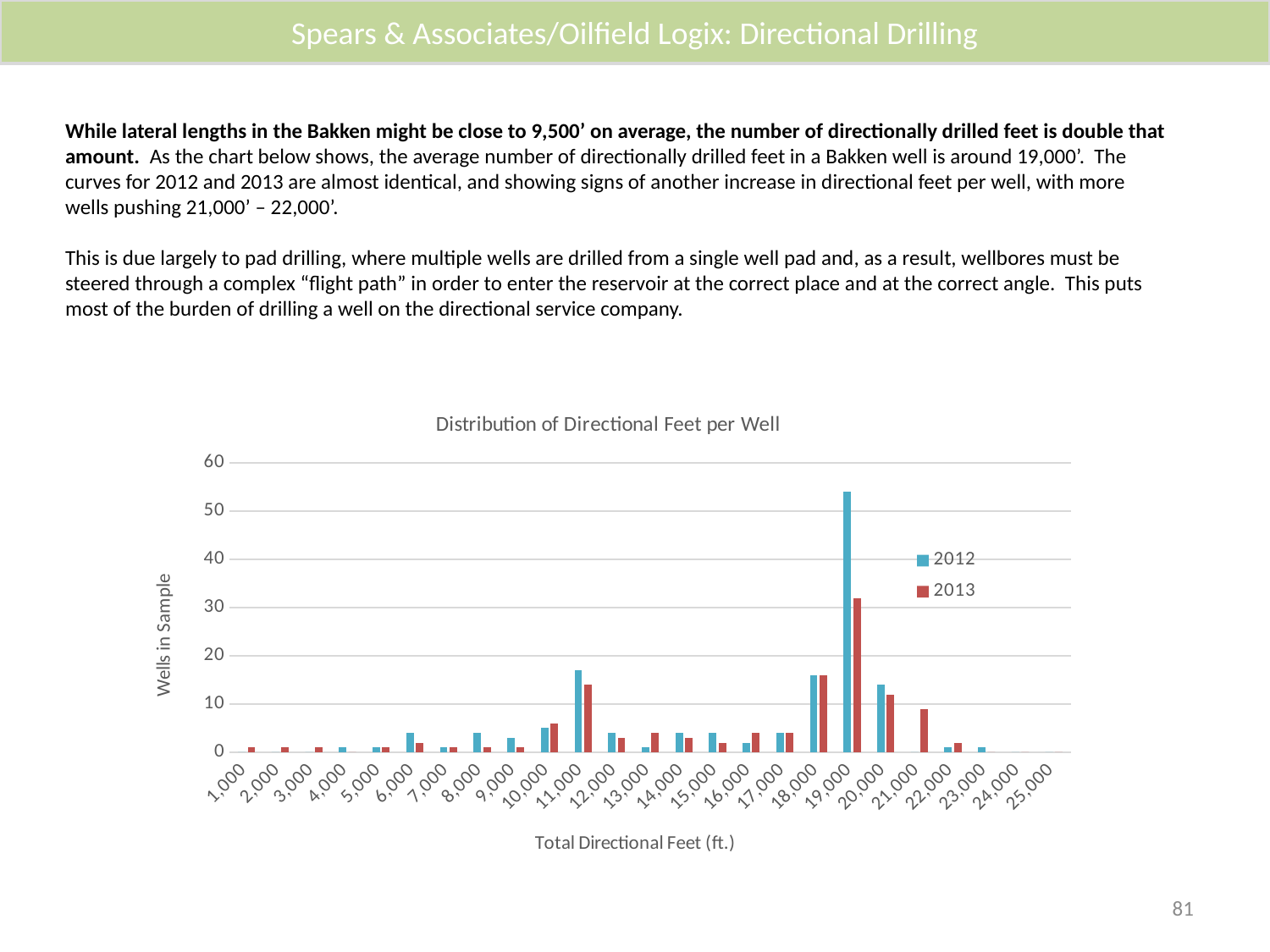
At 21,000 feet, which series has the larger value, 2012 or 2013? 2013 At 19,000 feet, which series has the larger value, 2012 or 2013? 2012 Is the 2012 value for 11,000 greater or less than 10? greater What is the label of the vertical axis of the chart? Wells in Sample Which category has the highest value for the 2013 series? 19,000 What kind of chart is shown on the slide? bar chart Which category has the highest value for the 2012 series? 19,000 Is the 2013 value for 19,000 greater or less than 40? less What is the title of the chart? Distribution of Directional Feet per Well Is the 2012 value for 19,000 greater or less than 50? greater How many series does the chart legend list? 2 How many categories are shown along the x axis of the chart? 25